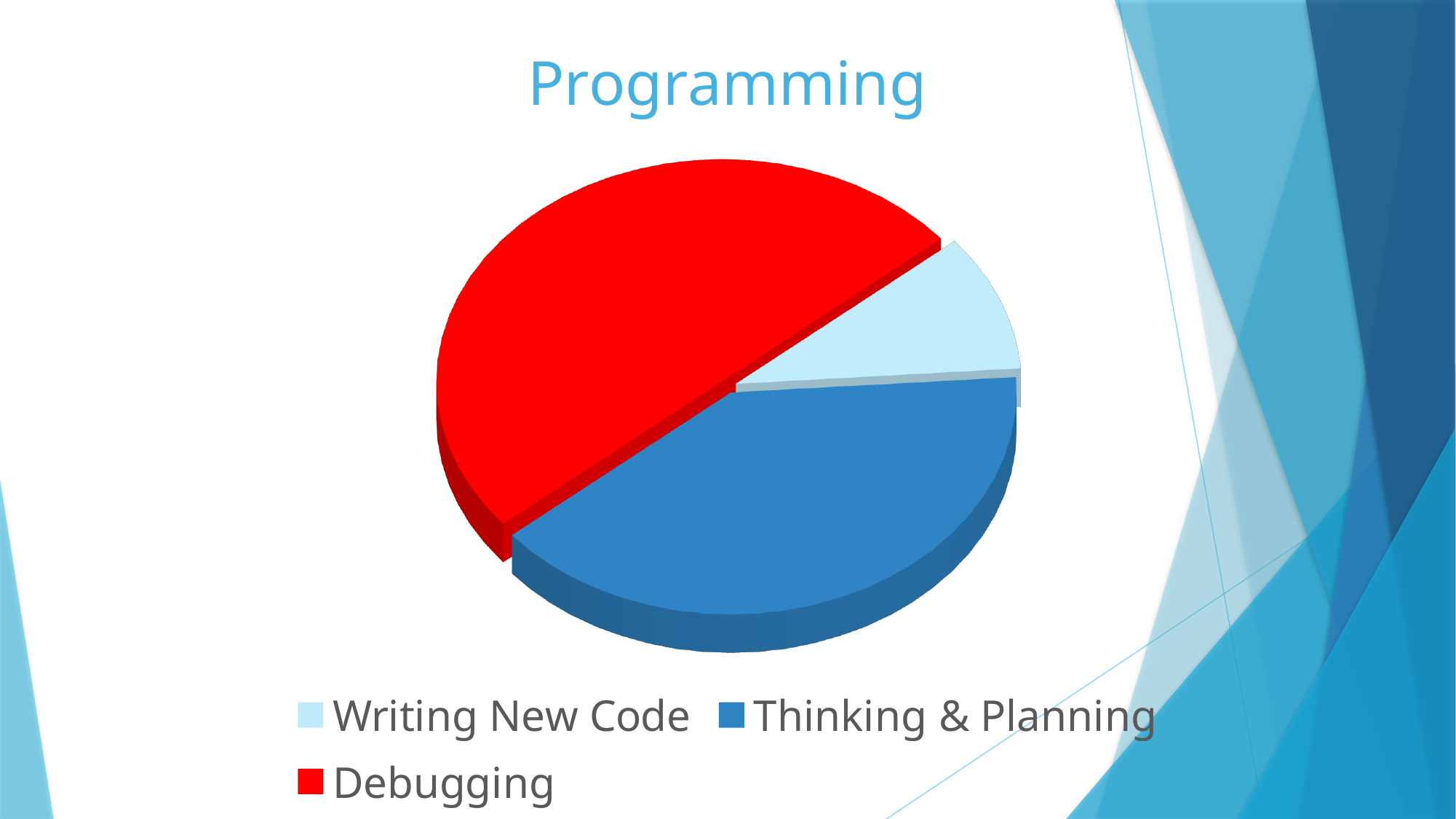
Which slice is larger, Thinking & Planning or Writing New Code? Thinking & Planning What is the title of the chart? Programming Which slice is larger, Debugging or Thinking & Planning? Debugging What colour is the Debugging slice? Red Which category has the largest slice of the pie? Debugging What kind of chart is shown on the slide? Pie chart How many slices does the pie chart have? 3 How many entries does the legend list? 3 Which category has the smallest slice of the pie? Writing New Code Which slice is smaller, Writing New Code or Debugging? Writing New Code